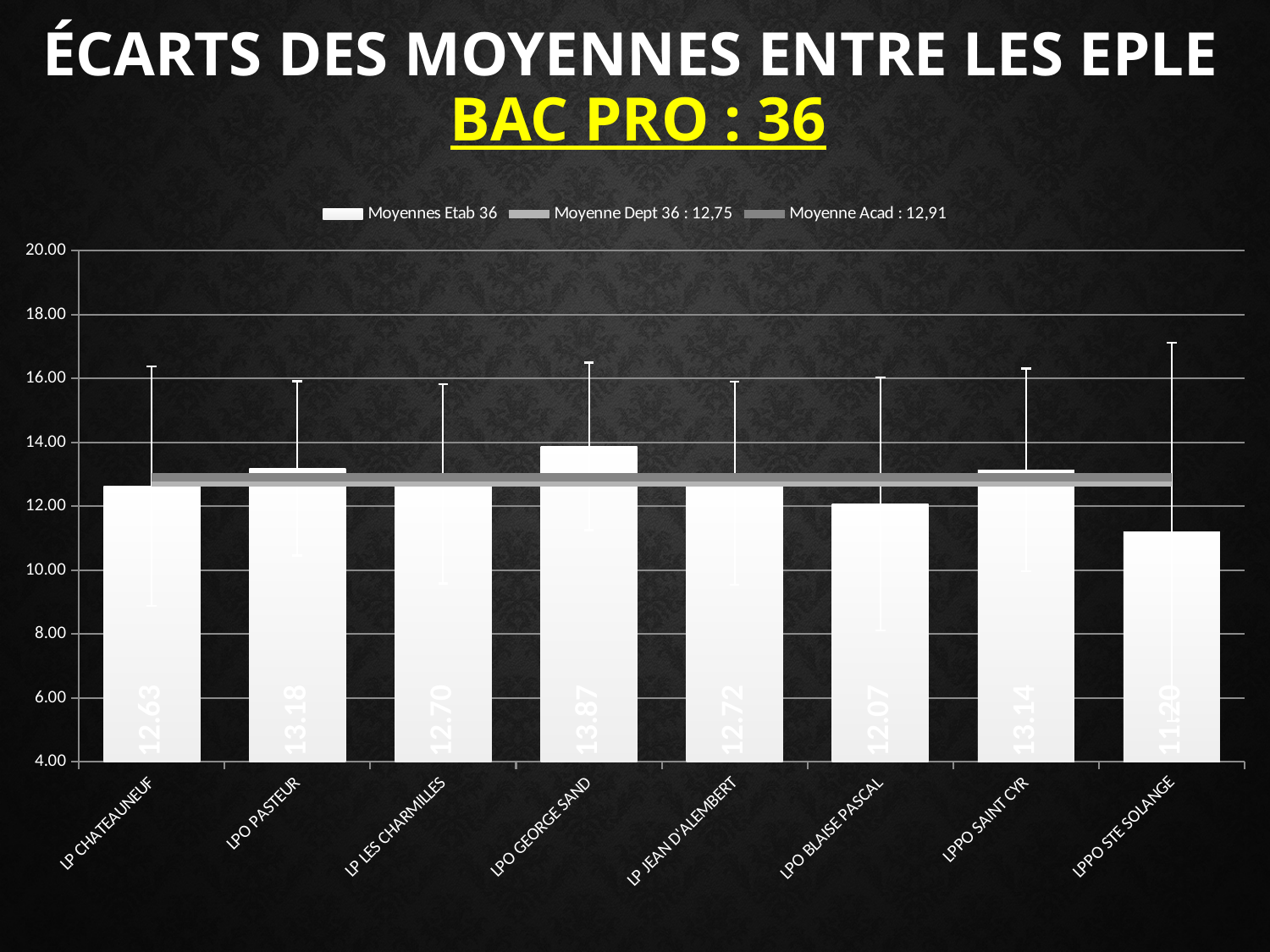
What is the value for LP CHATEAUNEUF? 12.63 Which establishment has the lowest average? LPPO STE SOLANGE Which is larger, the value for LPO PASTEUR or the value for LPO BLAISE PASCAL? LPO PASTEUR What is the value for LPO GEORGE SAND? 13.87 What is the difference between the values for LPO GEORGE SAND and LPPO STE SOLANGE? 2.67 According to the legend, what is the value of Moyenne Dept 36? 12,75 Is the value for LPO BLAISE PASCAL greater or less than 14.00? less How many establishments are shown on the x axis? 8 Which establishment has the highest average? LPO GEORGE SAND What is the value for LPPO STE SOLANGE? 11.20 What kind of chart is shown on the slide? bar chart How many series does the legend list? 3